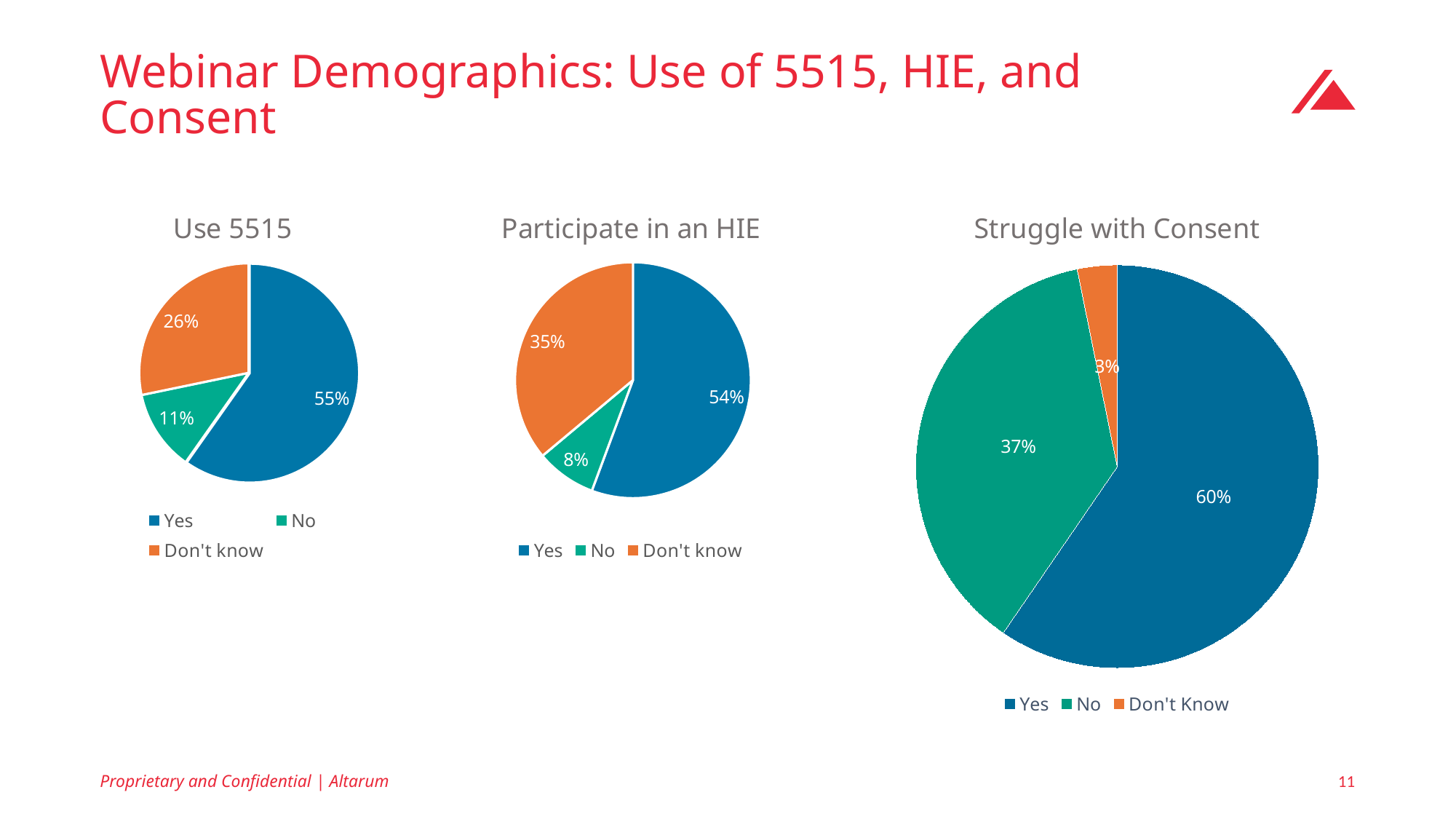
In the 'Struggle with Consent' chart, what colour is the Yes slice? Blue In the 'Participate in an HIE' chart, what percentage answered No? 8% In the 'Participate in an HIE' chart, which response has the largest slice? Yes In the 'Use 5515' chart, what percentage answered Yes? 55% What type of chart is 'Participate in an HIE'? Pie chart In the 'Participate in an HIE' chart, which is larger, the Don't know slice or the No slice? Don't know How many slices does the 'Struggle with Consent' pie chart have? 3 In the 'Struggle with Consent' chart, what percentage answered No? 37% In the 'Struggle with Consent' chart, which response has the smallest slice? Don't Know In the 'Use 5515' chart, what percentage answered Don't know? 26% In the 'Use 5515' chart, what is the difference between the Yes and No percentages? 44% How many entries does the legend of the 'Use 5515' chart list? 3